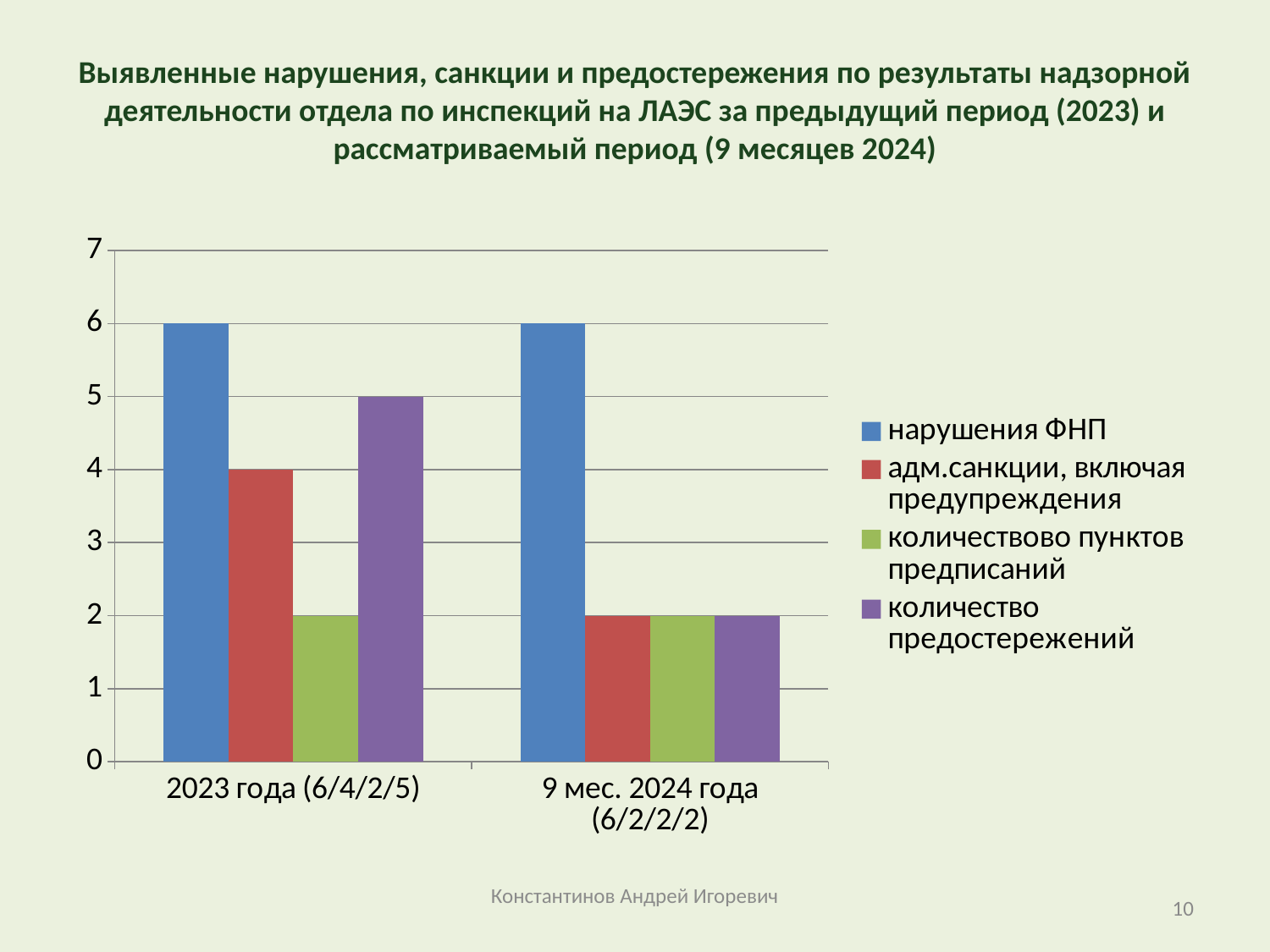
What is the value of адм.санкции, включая предупреждения for 2023 года? 4 Which series is shown in purple in the legend? количество предостережений Which series has the lowest value for 2023 года? количествово пунктов предписаний What is the value of количествово пунктов предписаний for 2023 года? 2 How many categories are shown on the x axis? 2 What is the difference between количество предостережений for 2023 года and for 9 мес. 2024 года? 3 What is the value of нарушения ФНП for 2023 года? 6 How many series does the legend list? 4 What kind of chart is shown on the slide? bar chart What is the value of количество предостережений for 9 мес. 2024 года? 2 Which is larger: адм.санкции, включая предупреждения for 2023 года or for 9 мес. 2024 года? 2023 года Which series has the highest value for 2023 года? нарушения ФНП